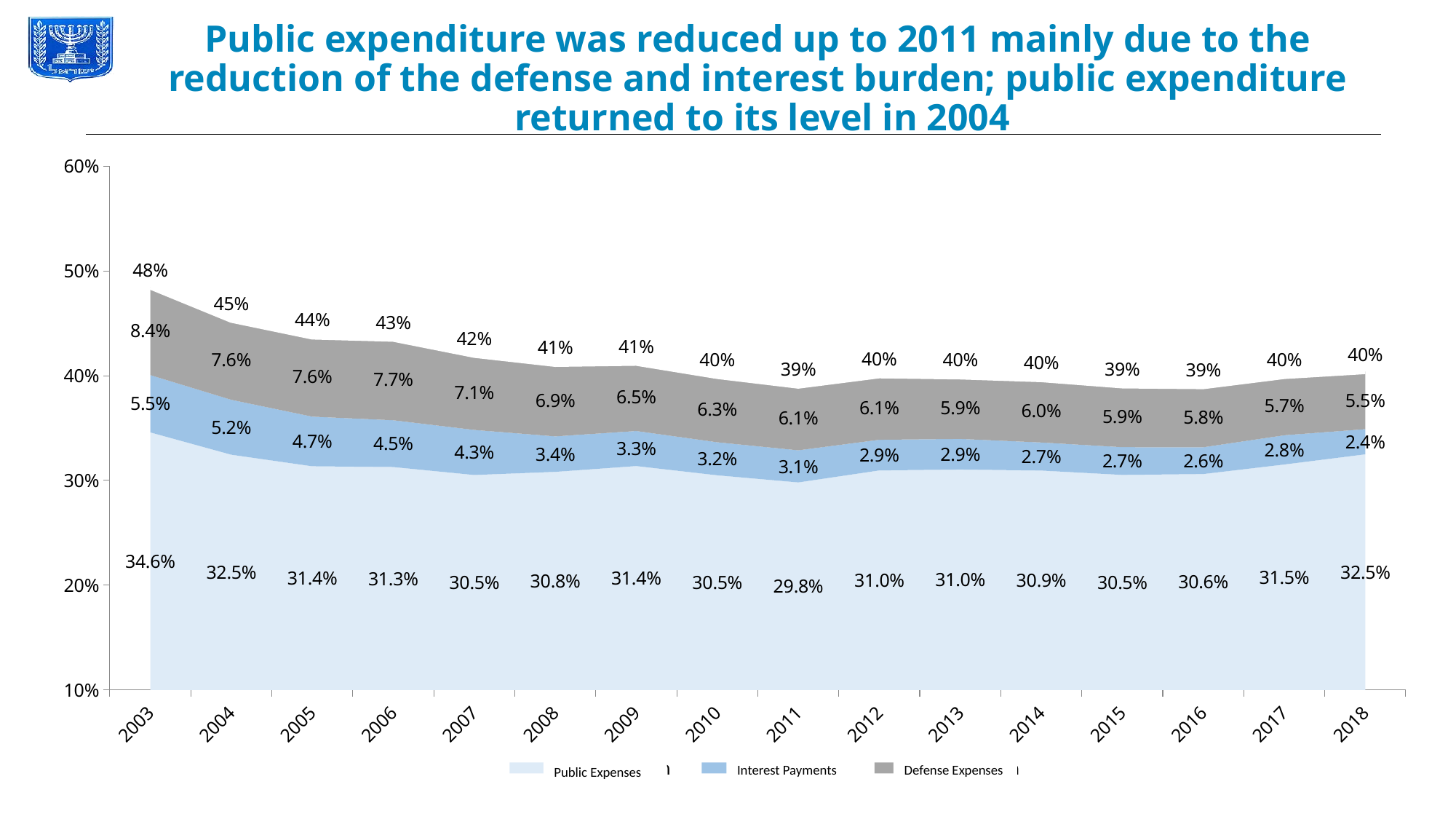
What is the difference between Defense Expenses in 2003 and in 2018? 2.9 percentage points How many years are shown on the x axis? 16 What is the value for Defense Expenses in 2006? 7.7% In which year is Interest Payments lowest? 2018 What kind of chart is shown on the slide? Stacked area chart What is the value for Public Expenses in 2003? 34.6% In which year is Public Expenses lowest? 2011 How many series does the legend list? 3 What is the total public expenditure shown for 2003? 48% Which is larger: Interest Payments in 2005 or in 2010? 2005 What is the value for Interest Payments in 2011? 3.1% In which year is Defense Expenses highest? 2003